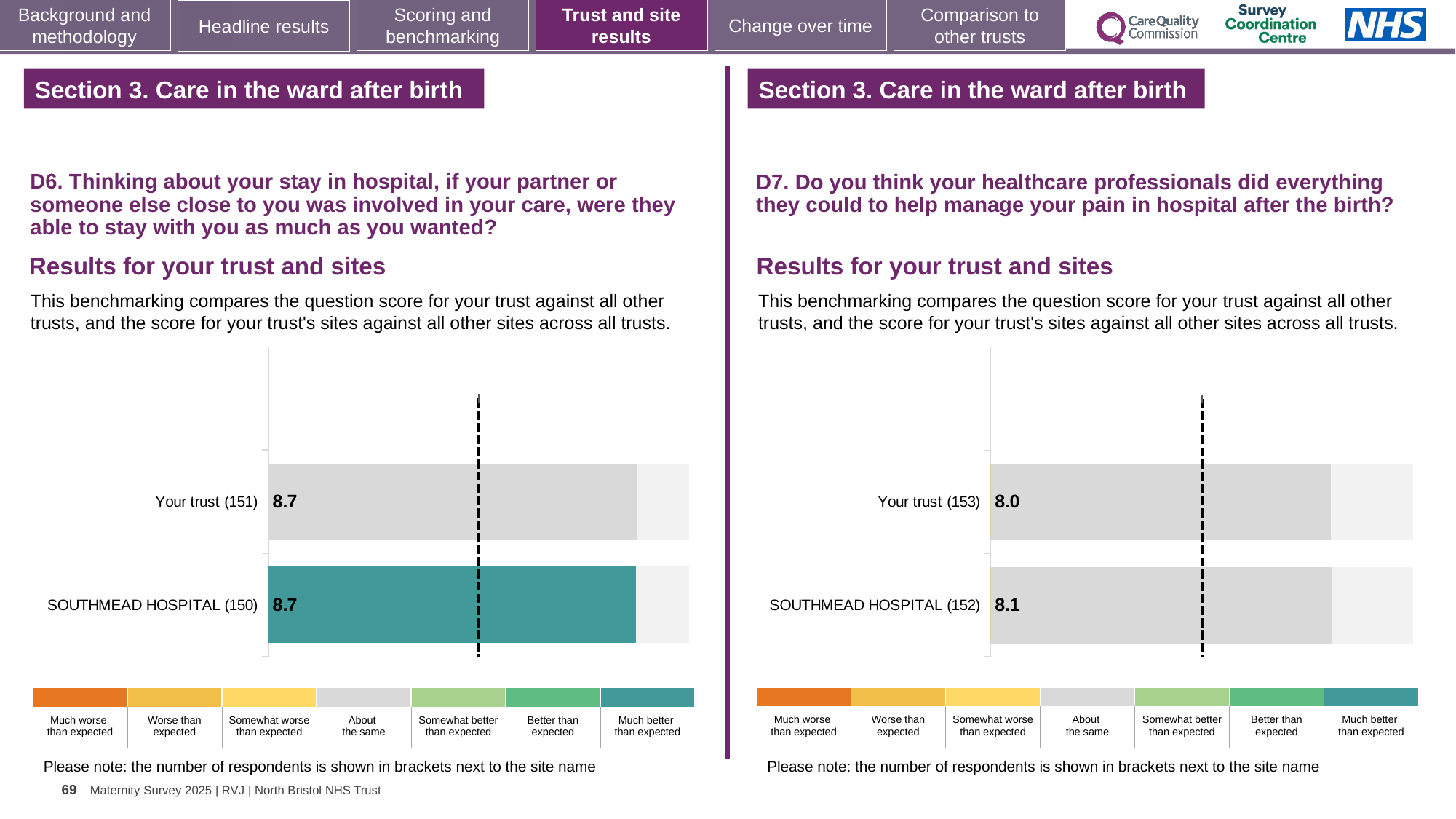
How many bars are plotted in the D7 chart on the right? 2 In the D7 chart on the right, which has the higher score, Your trust or SOUTHMEAD HOSPITAL? SOUTHMEAD HOSPITAL How many bars are plotted in the D6 chart on the left? 2 In the D6 chart on the left, what is the score for Your trust (151)? 8.7 In the D6 chart on the left, what is the score for SOUTHMEAD HOSPITAL (150)? 8.7 In the D7 chart on the right, what is the score for Your trust (153)? 8.0 What type of chart is used in the D6 chart on the left? Bar chart In the D6 chart on the left, which benchmark category does the colour of the SOUTHMEAD HOSPITAL bar correspond to? Much better than expected In the D7 chart on the right, what is the difference between the SOUTHMEAD HOSPITAL score and the Your trust score? 0.1 In the D7 chart on the right, what is the score for SOUTHMEAD HOSPITAL (152)? 8.1 In the D6 chart on the left, is the score for Your trust higher than, lower than, or equal to the score for SOUTHMEAD HOSPITAL? equal In the D7 chart on the right, how many respondents are shown in brackets for SOUTHMEAD HOSPITAL? 152